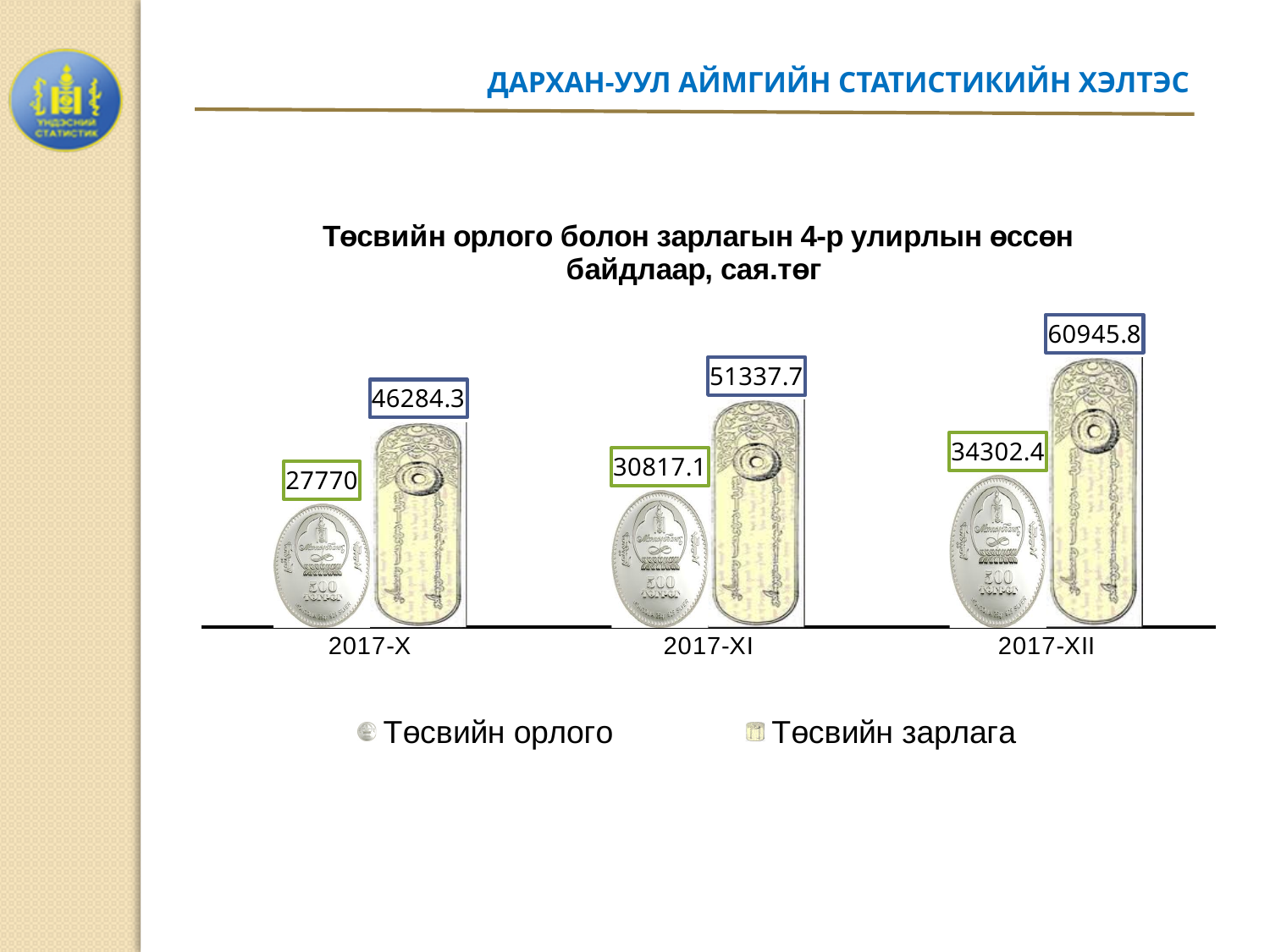
In which period is Төсвийн орлого lowest? 2017-X What is the value of Төсвийн зарлага for 2017-XII? 60945.8 How many periods are shown on the x axis? 3 Does Төсвийн зарлага rise or fall from 2017-X to 2017-XII? rise What is the value of Төсвийн орлого for 2017-X? 27770 What is the difference between Төсвийн зарлага and Төсвийн орлого in 2017-XII? 26643.4 In which period is Төсвийн зарлага highest? 2017-XII What is the value of Төсвийн орлого for 2017-XII? 34302.4 By how much did Төсвийн орлого increase from 2017-X to 2017-XII? 6532.4 What is the value of Төсвийн зарлага for 2017-XI? 51337.7 How many series does the legend list? 2 Which is larger in 2017-XI, Төсвийн орлого or Төсвийн зарлага? Төсвийн зарлага